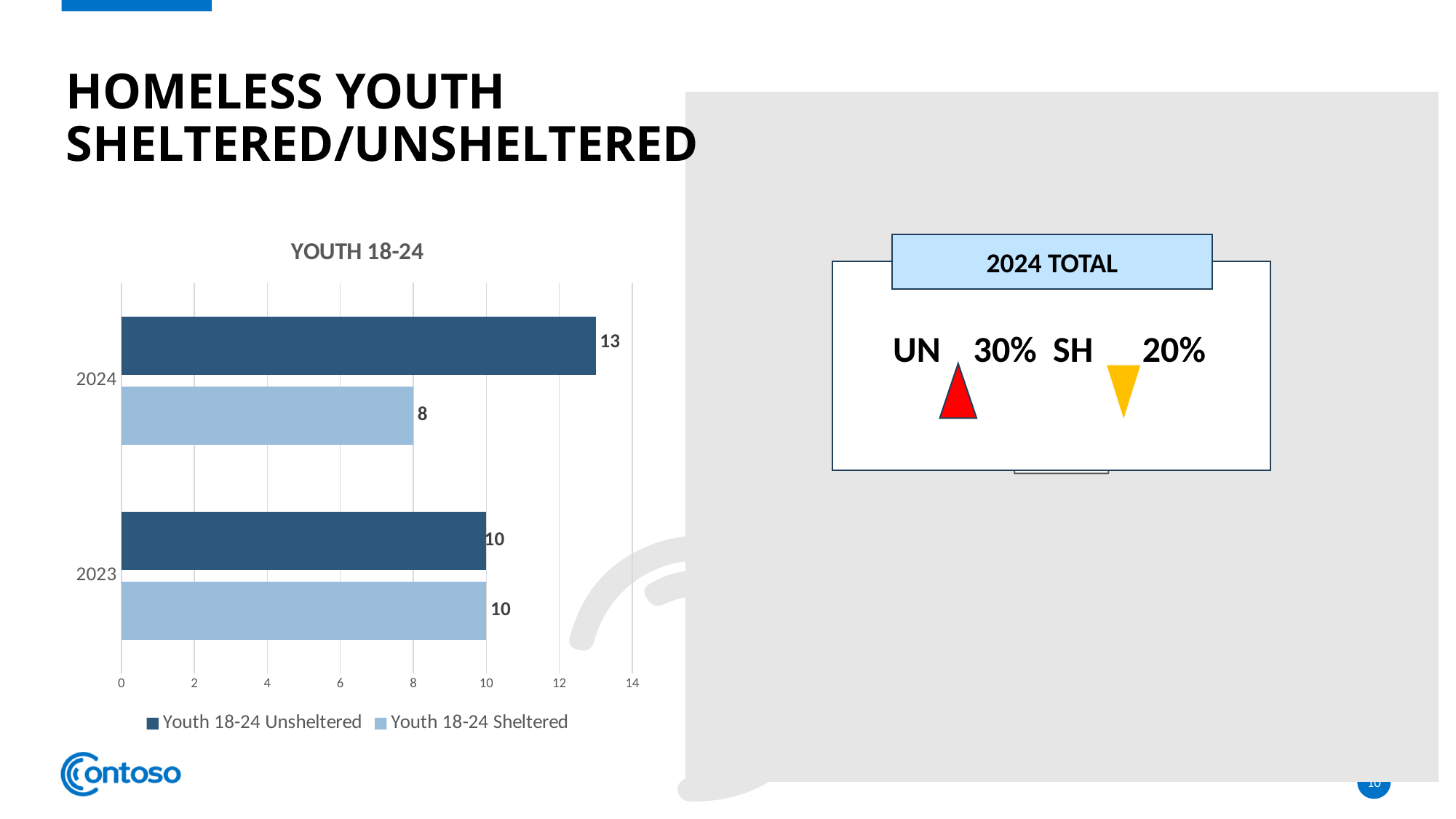
What is the difference between the Unsheltered and Sheltered values in 2024? 5 What is the value for Youth 18-24 Sheltered in 2023? 10 Which year has the lowest value for Youth 18-24 Sheltered? 2024 What is the title of the chart? YOUTH 18-24 How many series does the legend list? 2 What is the value for Youth 18-24 Sheltered in 2024? 8 What is the value for Youth 18-24 Unsheltered in 2024? 13 Which year has the highest value for Youth 18-24 Unsheltered? 2024 What is the value for Youth 18-24 Unsheltered in 2023? 10 What kind of chart is shown on the slide? Bar chart In 2024, which is larger: Youth 18-24 Unsheltered or Youth 18-24 Sheltered? Youth 18-24 Unsheltered How many years are shown on the chart? 2